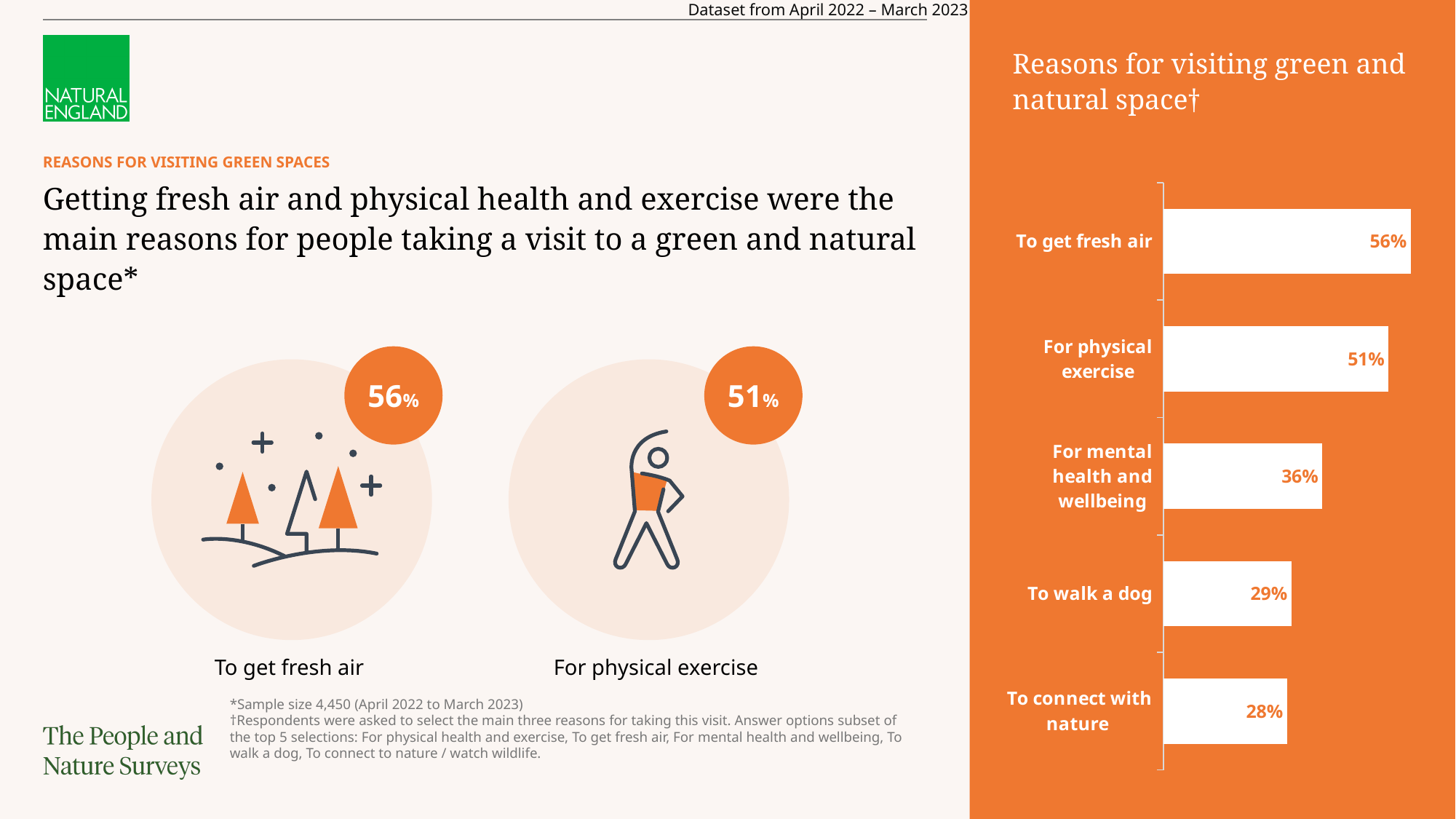
What is the difference between the values for 'To get fresh air' and 'For physical exercise'? 5% What percentage of respondents gave 'To get fresh air' as a reason for visiting green and natural space? 56% What kind of chart is used to show the reasons for visiting green and natural space? Bar chart How many reasons are shown in the bar chart? 5 What is the difference between the values for 'For mental health and wellbeing' and 'To walk a dog'? 7% What is the value for 'To connect with nature' in the bar chart? 28% Which reason has the lowest value in the bar chart? To connect with nature What is the value for 'For mental health and wellbeing' in the bar chart? 36% What is the title of the bar chart? Reasons for visiting green and natural space† Which is larger: the value for 'For physical exercise' or the value for 'For mental health and wellbeing'? For physical exercise What is the value for 'To walk a dog' in the bar chart? 29% Which reason has the highest value in the bar chart? To get fresh air